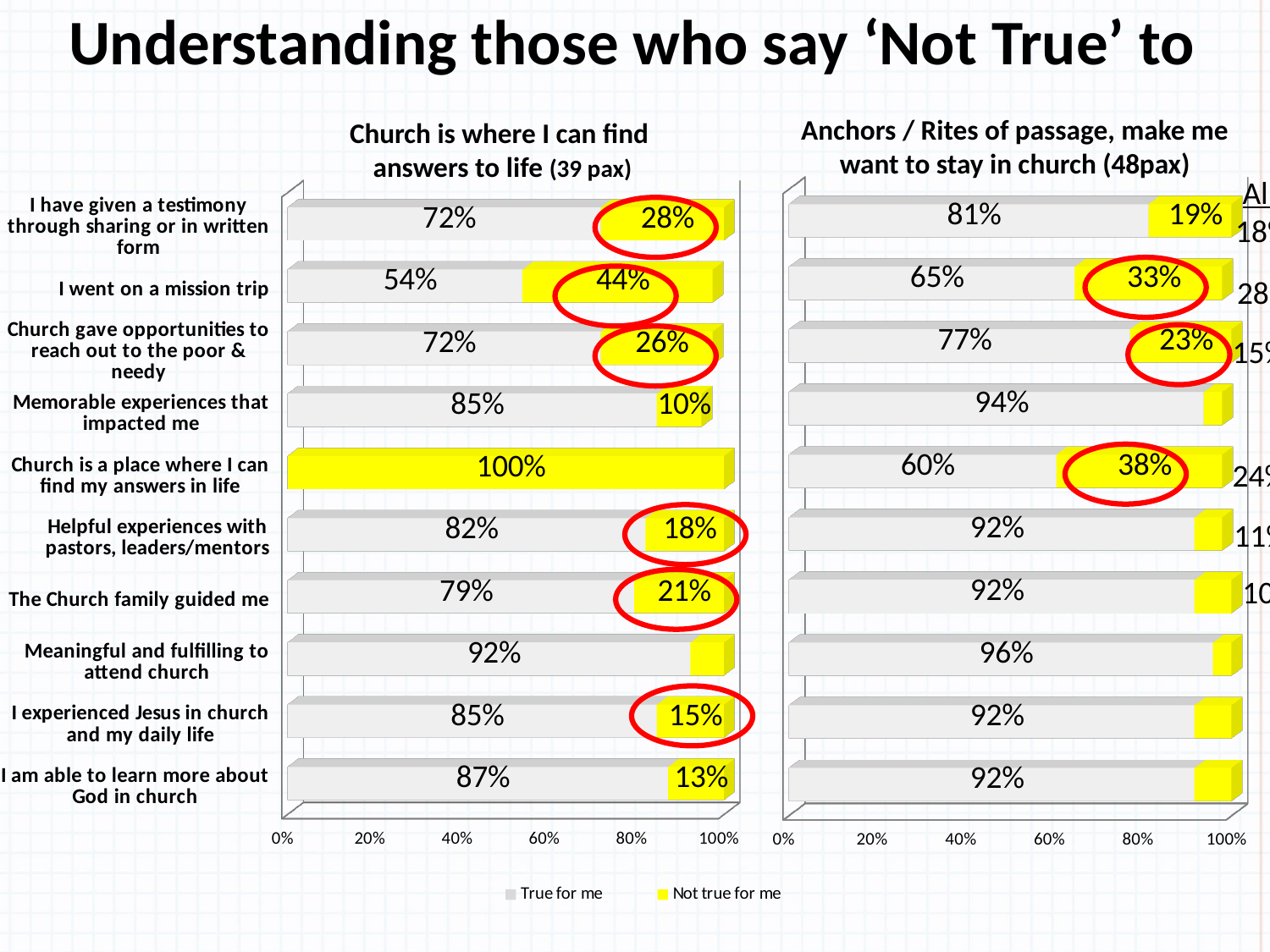
How many series does the legend list? 2 In the 'Anchors / Rites of passage' chart, what is the 'Not true for me' value for 'Church is a place where I can find my answers in life'? 38% In the 'Church is where I can find answers to life' chart, what is the difference between the 'Not true for me' values for 'I went on a mission trip' and 'The Church family guided me'? 23% In the 'Church is where I can find answers to life' chart, which category has the highest 'Not true for me' value? Church is a place where I can find my answers in life In the 'Church is where I can find answers to life' chart, what is the 'True for me' value for 'I went on a mission trip'? 54% What kind of chart is the 'Anchors / Rites of passage' chart? Stacked bar chart In the 'Anchors / Rites of passage' chart, which category has the lowest 'True for me' value? Church is a place where I can find my answers in life In the 'Anchors / Rites of passage' chart, which is larger: the 'Not true for me' value for 'I went on a mission trip' or for 'Church gave opportunities to reach out to the poor & needy'? I went on a mission trip In the 'Anchors / Rites of passage' chart, is the 'True for me' value for 'I have given a testimony through sharing or in written form' greater or less than 60%? greater How many categories are shown in the 'Church is where I can find answers to life' chart? 10 In the 'Church is where I can find answers to life' chart, what is the 'Not true for me' value for 'I have given a testimony through sharing or in written form'? 28% In the 'Anchors / Rites of passage' chart, what is the 'True for me' value for 'Meaningful and fulfilling to attend church'? 96%